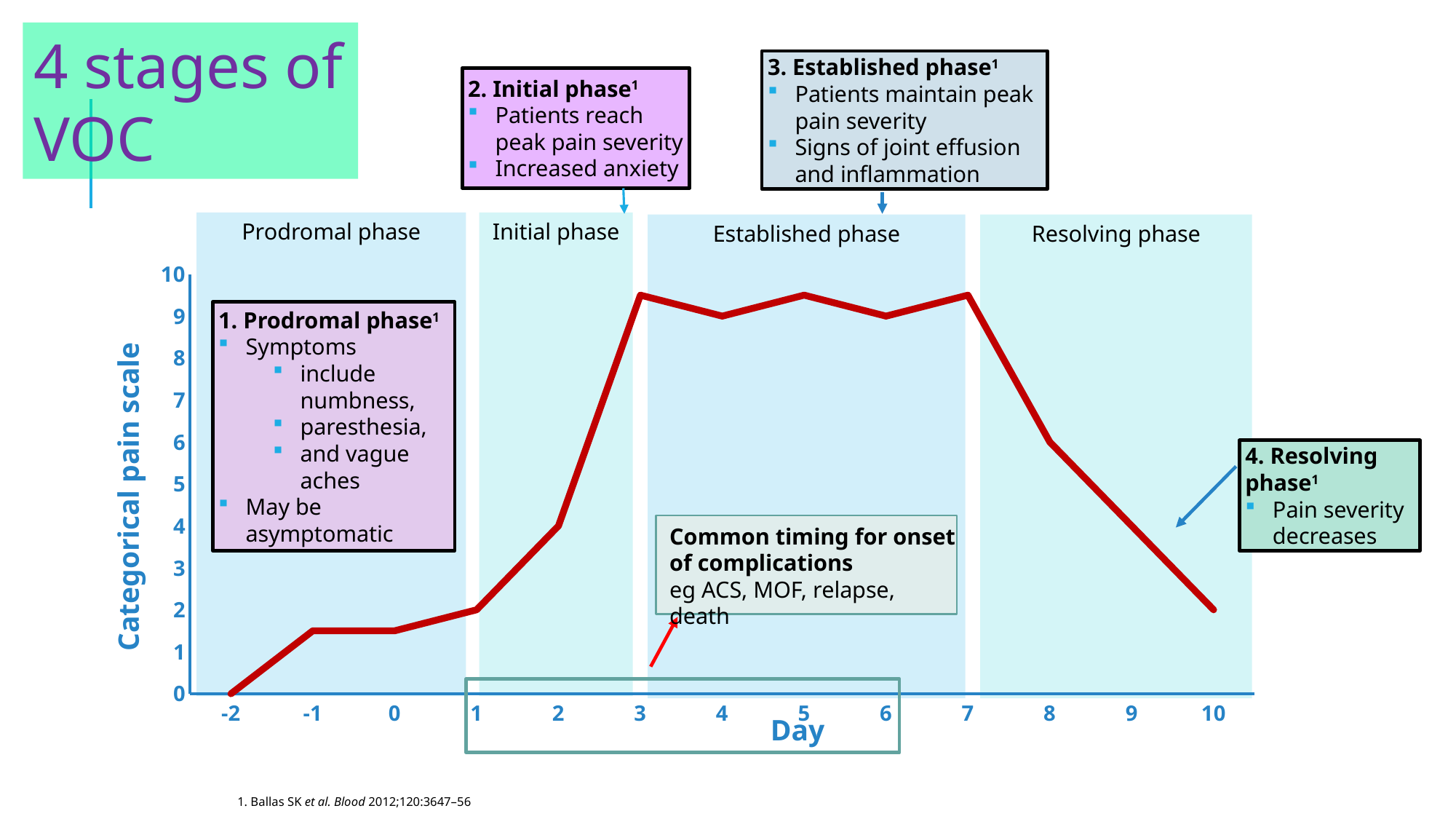
Is the pain scale value at day -1 greater or less than 3? less How many days are marked on the x axis? 13 What is the categorical pain scale value at day 8? 6 What is the title of the vertical axis? Categorical pain scale Is the pain scale value at day 3 greater or less than 8? greater What is the categorical pain scale value at day 1? 2 What is the categorical pain scale value at day 10? 2 Does the pain scale value rise or fall between day -2 and day 3? rise What kind of chart is shown on the slide? line chart Which has the higher pain scale value, day 2 or day 7? day 7 What is the categorical pain scale value at day -2? 0 What is the title of the horizontal axis? Day